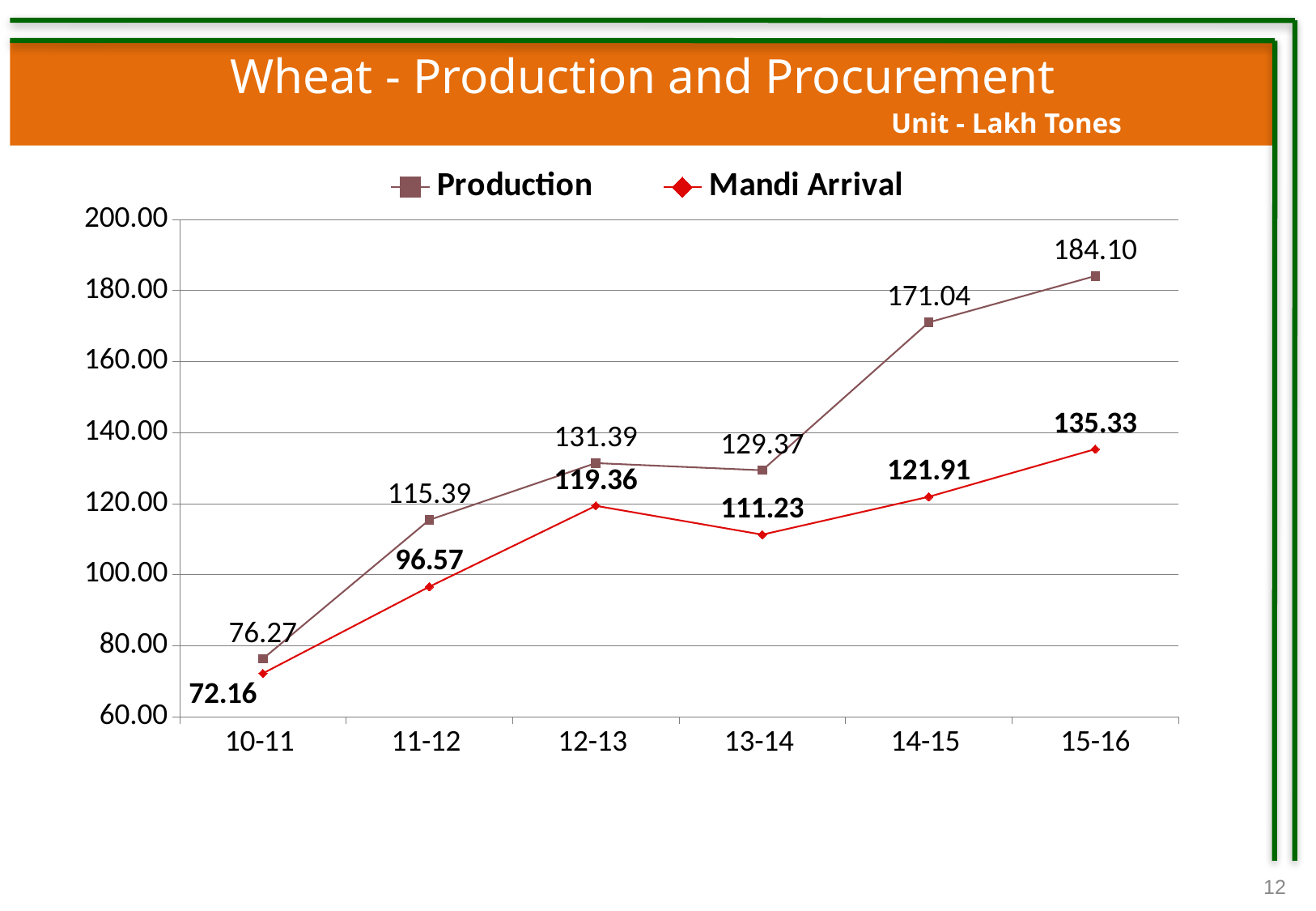
How many series does the legend list? 2 How many years are shown on the x axis? 6 In which year is Mandi Arrival lowest? 10-11 What is the Production value for 14-15? 171.04 What unit is stated for the values in the chart? Lakh Tones What is the Mandi Arrival value for 13-14? 111.23 What is the Mandi Arrival value for 11-12? 96.57 In which year is Production highest? 15-16 Which is larger in 12-13: Production or Mandi Arrival? Production What kind of chart is shown on the slide? Line chart What is the difference between Production and Mandi Arrival in 15-16? 48.77 Is the Production value for 13-14 greater or less than 120.00? greater